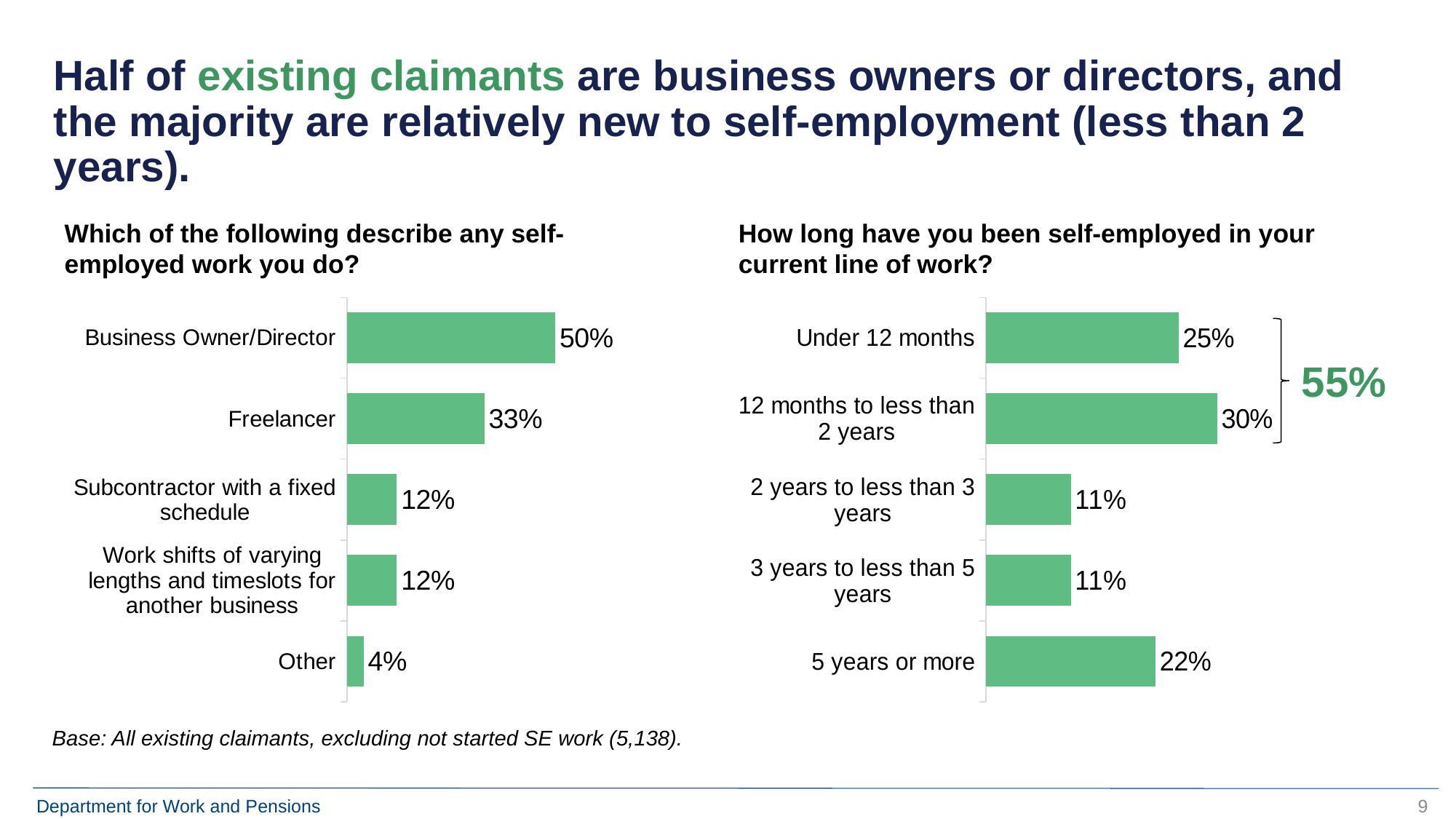
In the left chart (Which of the following describe any self-employed work you do?), how many categories are shown? 5 In the left chart (Which of the following describe any self-employed work you do?), which category has the lowest value? Other In the right chart (How long have you been self-employed in your current line of work?), which category has the highest value? 12 months to less than 2 years In the right chart (How long have you been self-employed in your current line of work?), what is the difference between 12 months to less than 2 years and 2 years to less than 3 years? 19% In the right chart (How long have you been self-employed in your current line of work?), what is the combined value of Under 12 months and 12 months to less than 2 years? 55% What type of chart is the right chart (How long have you been self-employed in your current line of work?)? Bar chart In the left chart (Which of the following describe any self-employed work you do?), what is the difference between Business Owner/Director and Freelancer? 17% In the right chart (How long have you been self-employed in your current line of work?), which is larger: Under 12 months or 5 years or more? Under 12 months In the right chart (How long have you been self-employed in your current line of work?), what is the value for 5 years or more? 22% What is the base stated below the charts? All existing claimants, excluding not started SE work (5,138) In the left chart (Which of the following describe any self-employed work you do?), what is the value for Freelancer? 33% In the left chart (Which of the following describe any self-employed work you do?), which category has the highest value? Business Owner/Director